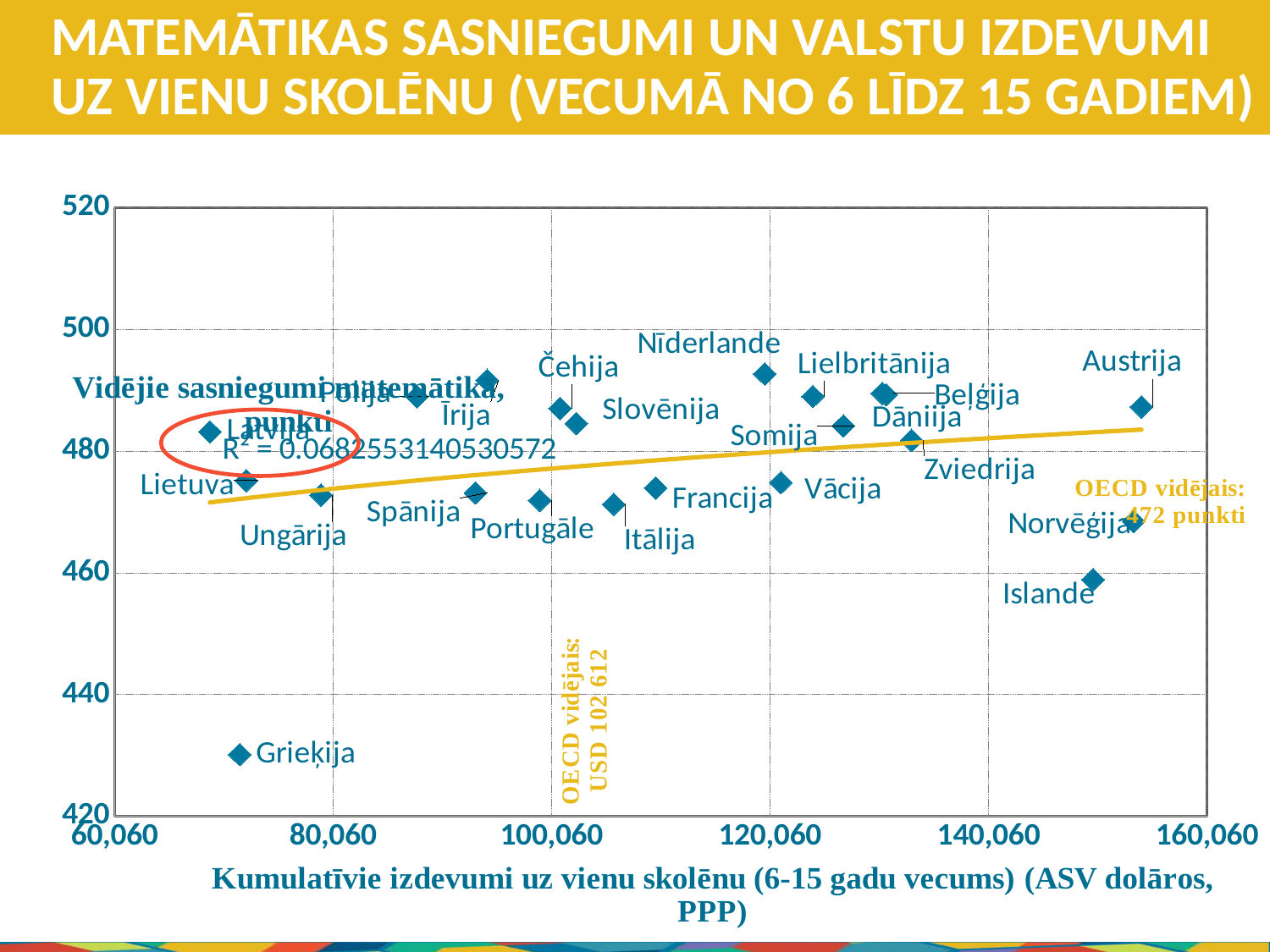
Which country has a higher mathematics score, Austrija or Grieķija? Austrija What kind of chart is shown on the slide? scatter chart Does the trend line rise or fall as spending per student increases? rises Is the cumulative spending per student for Austrija greater or less than 140,060? greater Which country has a higher mathematics score, Nīderlande or Islande? Nīderlande Is the mathematics score for Grieķija greater or less than 440? less Is the mathematics score for Austrija greater or less than 480? greater Which country is circled in red on the chart? Latvija What is the OECD average mathematics score noted on the chart? 472 punkti Which country has the lowest mathematics score on the chart? Grieķija